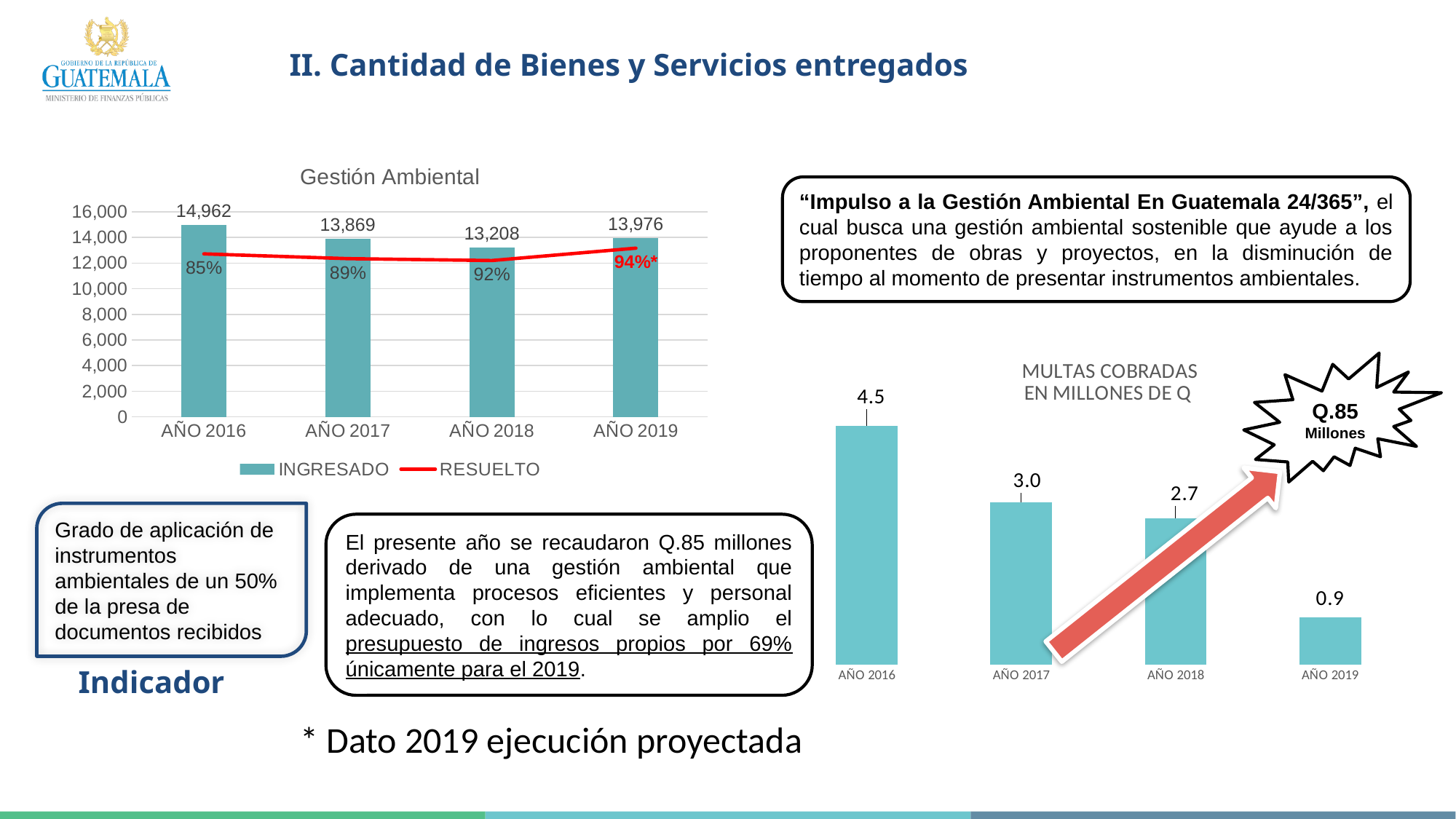
In the MULTAS COBRADAS EN MILLONES DE Q chart, which year has the lowest value? AÑO 2019 In the Gestión Ambiental chart, what is the INGRESADO value for AÑO 2018? 13,208 In the Gestión Ambiental chart, what is the INGRESADO value for AÑO 2016? 14,962 In the MULTAS COBRADAS EN MILLONES DE Q chart, what is the value for AÑO 2017? 3.0 In the Gestión Ambiental chart, which year has the lowest INGRESADO value? AÑO 2018 In the Gestión Ambiental chart, what is the RESUELTO value for AÑO 2017? 89% In the Gestión Ambiental chart, how many series does the legend list? 2 In the MULTAS COBRADAS EN MILLONES DE Q chart, what is the difference between the values for AÑO 2016 and AÑO 2019? 3.6 In the Gestión Ambiental chart, what is the difference between the INGRESADO values for AÑO 2016 and AÑO 2017? 1,093 In the Gestión Ambiental chart, which year has the highest INGRESADO value? AÑO 2016 What kind of chart is the MULTAS COBRADAS EN MILLONES DE Q chart? bar chart In the Gestión Ambiental chart, does the RESUELTO line rise or fall from AÑO 2016 to AÑO 2019? rise